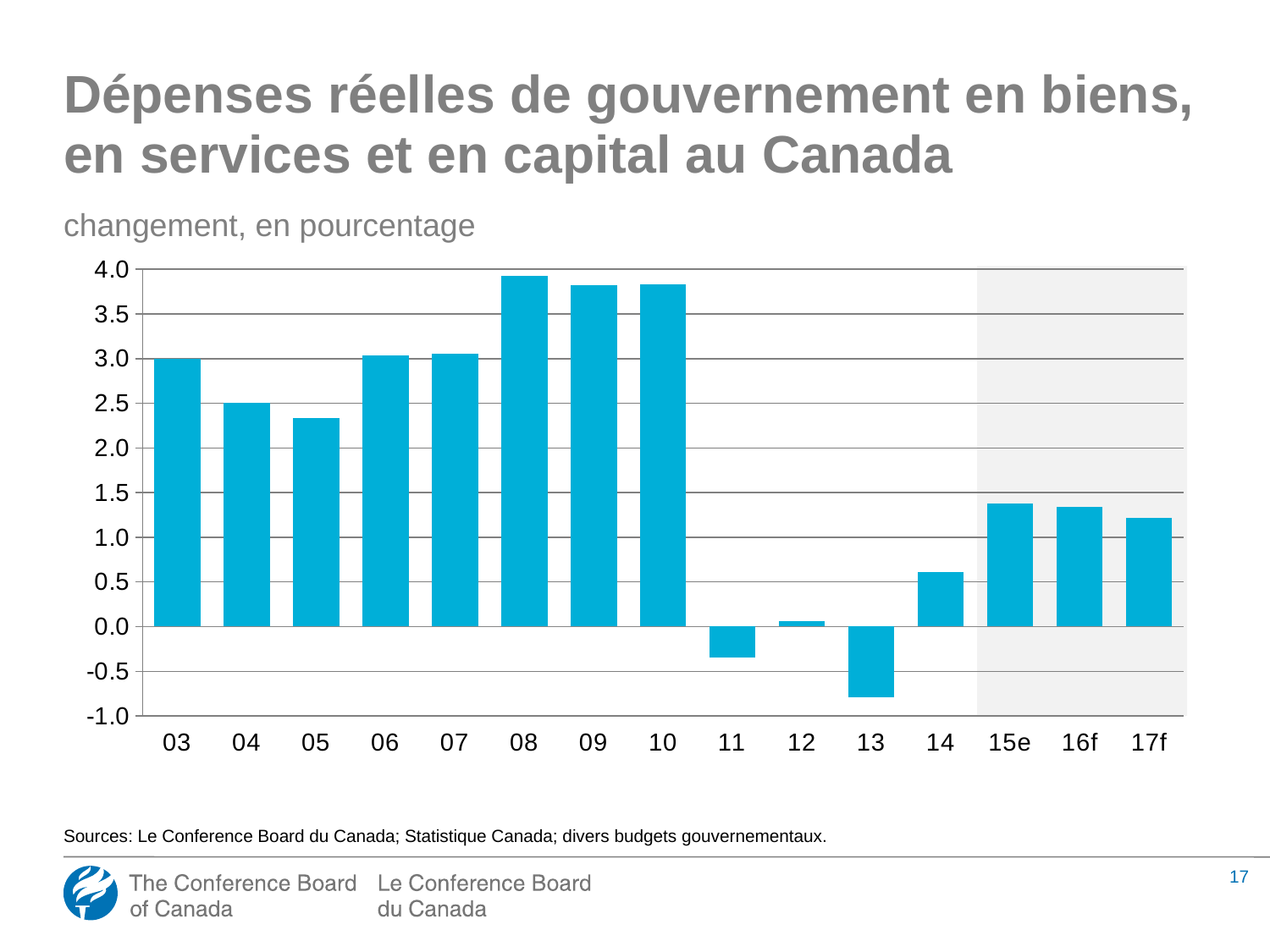
Is the value for 04 greater or less than 3.0? less Is the value for 14 greater or less than 1.0? less What unit does the subtitle say the values are in? changement, en pourcentage Do the values rise or fall from 10 to 13? fall Is the value for 08 greater or less than 3.5? greater Which is larger, the value for 03 or the value for 04? 03 Which is larger, the value for 11 or the value for 13? 11 Which year has the lowest value? 13 What kind of chart is shown on the slide? bar chart How many years (categories) are shown on the x axis? 15